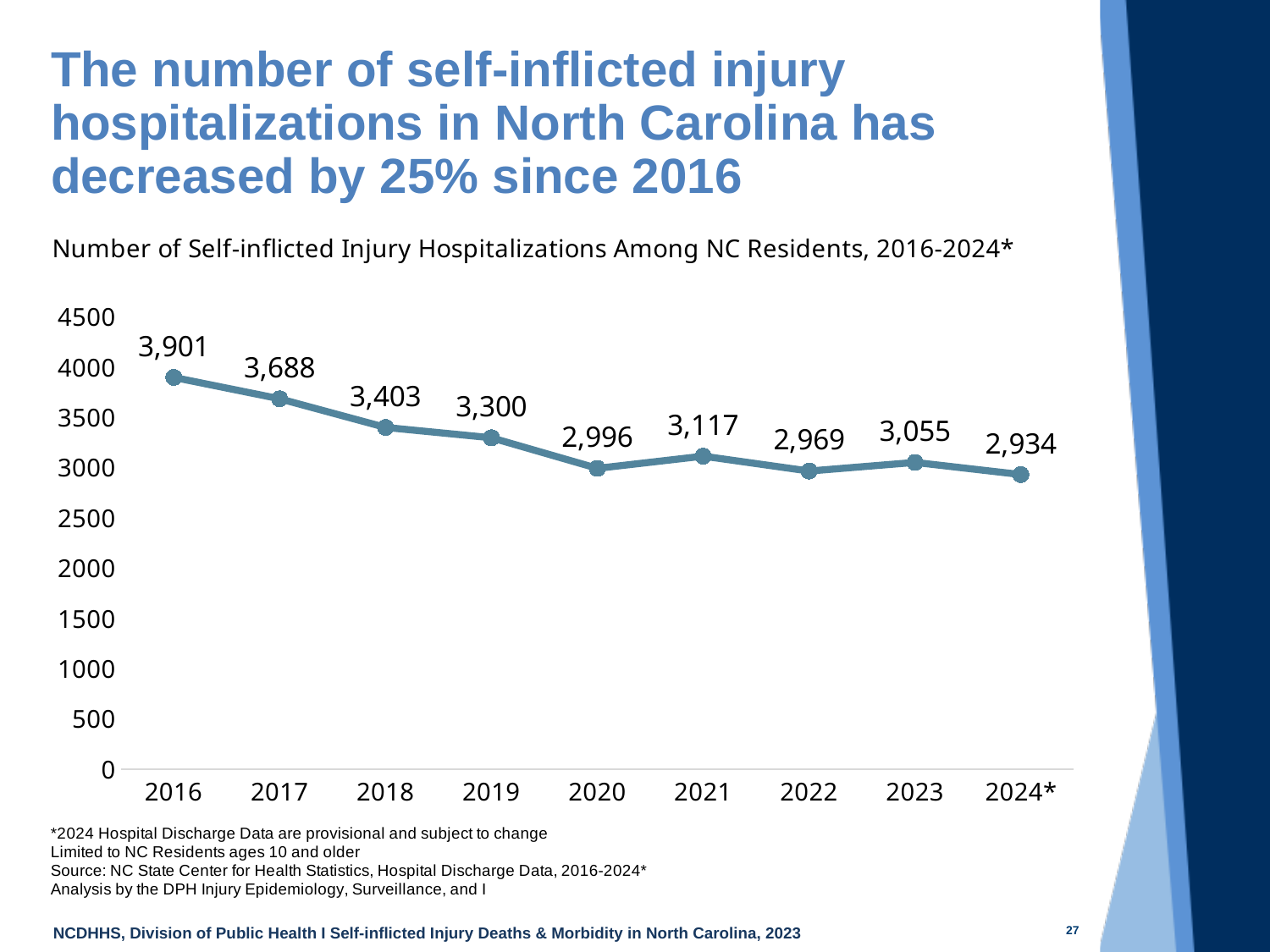
What is the number of self-inflicted injury hospitalizations in 2020? 2,996 What is the overall trend in hospitalizations from 2016 to 2024*? Decreasing What kind of chart is shown on the slide? Line chart What is the difference in hospitalizations between 2021 and 2020? 121 What is the number of self-inflicted injury hospitalizations in 2024*? 2,934 Which year has more hospitalizations, 2021 or 2022? 2021 Which year has the highest number of self-inflicted injury hospitalizations? 2016 How many years are plotted on the chart? 9 What is the number of self-inflicted injury hospitalizations in 2016? 3,901 Is the value for 2018 greater or less than 3500? less Which year has the lowest number of self-inflicted injury hospitalizations? 2024* What is the difference in hospitalizations between 2016 and 2024*? 967